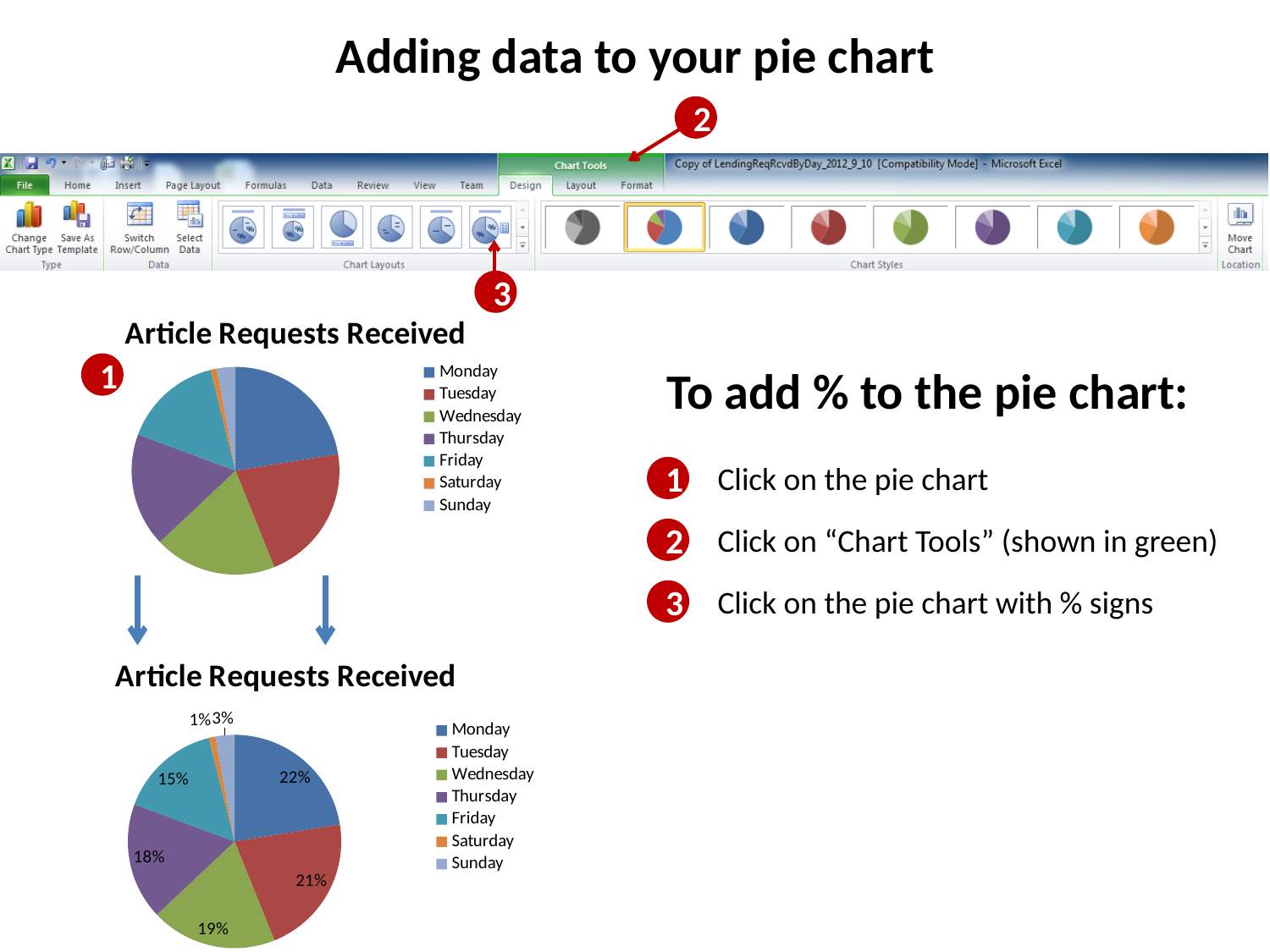
How many categories does the legend of the top pie chart list? 7 In the bottom pie chart, which is larger, the Thursday slice or the Sunday slice? Thursday In the bottom pie chart, what percentage is shown for Monday? 22% In the bottom pie chart, which day has the largest share? Monday What is the title of the top pie chart? Article Requests Received In the bottom pie chart, which day has the smallest share? Saturday In the bottom pie chart, what percentage is shown for Saturday? 1% In the bottom pie chart, what percentage is shown for Wednesday? 19% What type of chart is shown at the bottom of the slide? pie chart In the bottom pie chart, what is the difference between the Monday and Friday percentages? 7% In the bottom pie chart, what percentage is shown for Friday? 15% In the bottom pie chart, what percentage is shown for Tuesday? 21%